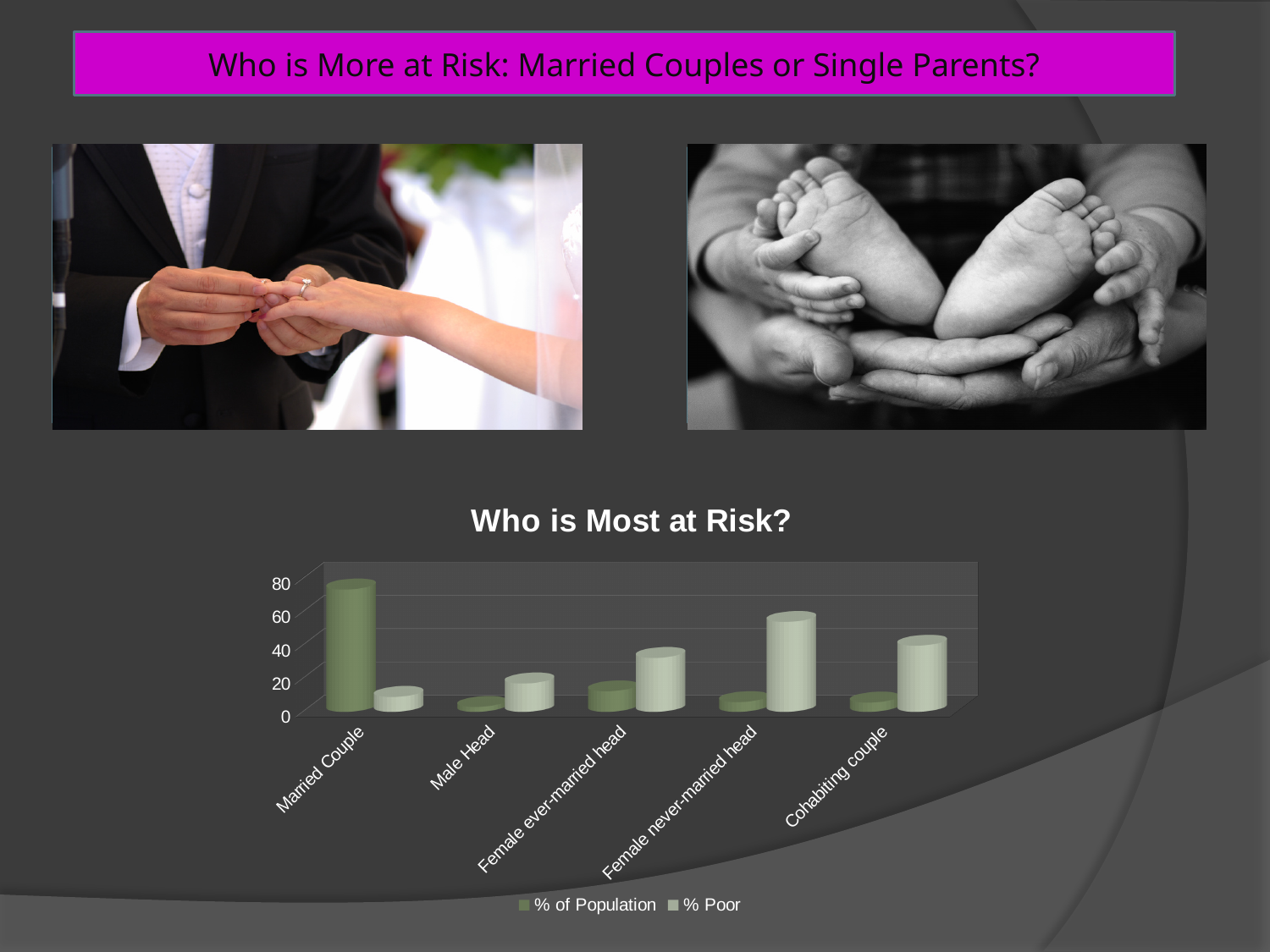
What kind of chart is shown on the slide? bar chart Is the % Poor value for Female never-married head greater or less than 40? greater For Cohabiting couple, which is larger: % of Population or % Poor? % Poor Which category has the lowest value for % Poor? Married Couple For Married Couple, which is larger: % of Population or % Poor? % of Population Is the % of Population value for Married Couple greater or less than 60? greater How many categories are shown on the x axis of the chart? 5 What is the title of the chart? Who is Most at Risk? Which category has the highest value for % of Population? Married Couple Which category has the highest value for % Poor? Female never-married head How many series does the chart's legend list? 2